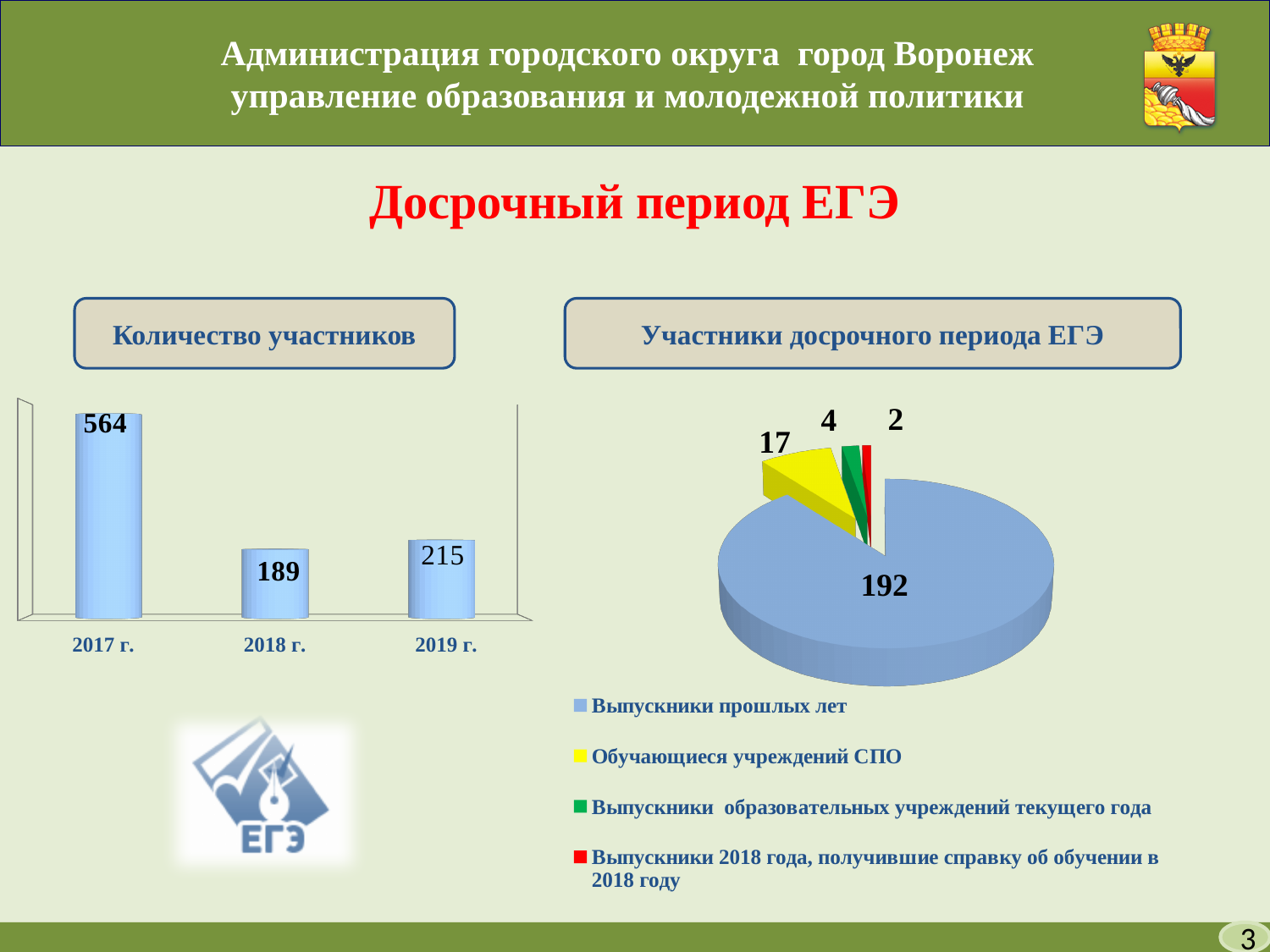
In the 'Участники досрочного периода ЕГЭ' chart, what is the value for 'Обучающиеся учреждений СПО'? 17 How many categories does the legend of the 'Участники досрочного периода ЕГЭ' chart list? 4 What type of chart is 'Участники досрочного периода ЕГЭ'? Pie chart In the 'Количество участников' chart, which year has the lowest value? 2018 г. In the 'Количество участников' chart, how many years are shown? 3 In the 'Количество участников' chart, what is the value for 2017 г.? 564 In the 'Участники досрочного периода ЕГЭ' chart, which is larger: 'Выпускники образовательных учреждений текущего года' or 'Выпускники 2018 года, получившие справку об обучении в 2018 году'? Выпускники образовательных учреждений текущего года In the 'Количество участников' chart, what is the value for 2019 г.? 215 In the 'Количество участников' chart, which year has the highest value? 2017 г. In the 'Количество участников' chart, what is the difference between the values for 2017 г. and 2018 г.? 375 What type of chart is 'Количество участников'? Bar chart In the 'Участники досрочного периода ЕГЭ' chart, which category has the largest slice? Выпускники прошлых лет